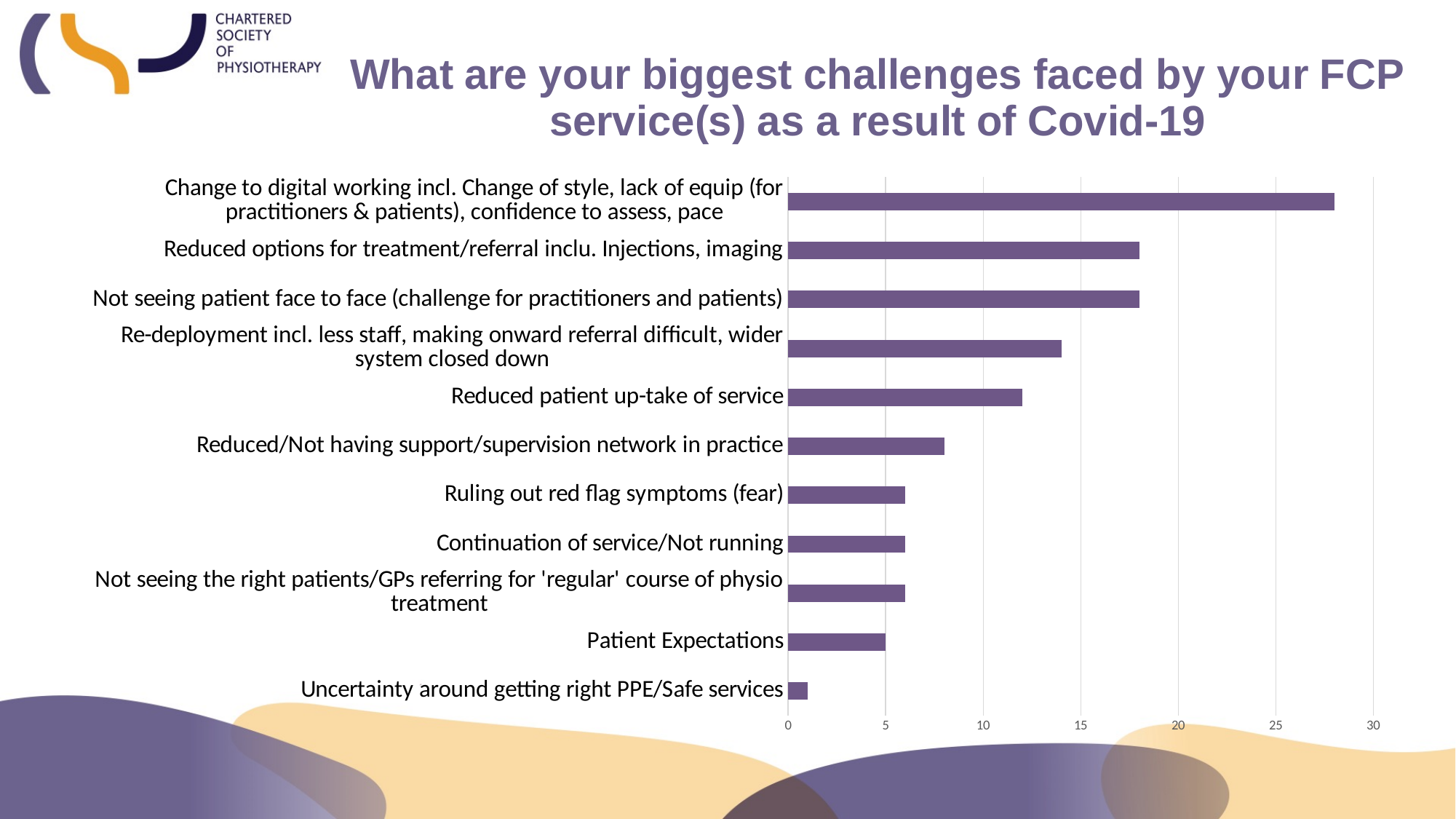
Is the value for 'Re-deployment incl. less staff, making onward referral difficult, wider system closed down' greater or less than 15? less Which has the larger value: 'Re-deployment incl. less staff, making onward referral difficult, wider system closed down' or 'Patient Expectations'? Re-deployment incl. less staff, making onward referral difficult, wider system closed down Is the value for 'Uncertainty around getting right PPE/Safe services' greater or less than 5? less What kind of chart is shown on the slide? bar chart Is the value for 'Change to digital working' greater or less than 25? greater Which has the larger value: 'Reduced patient up-take of service' or 'Reduced/Not having support/supervision network in practice'? Reduced patient up-take of service How many challenge categories are plotted in the chart? 11 What is the title of the chart on the slide? What are your biggest challenges faced by your FCP service(s) as a result of Covid-19 Which challenge has the lowest value in the chart? Uncertainty around getting right PPE/Safe services Which challenge has the highest value in the chart? Change to digital working incl. Change of style, lack of equip (for practitioners & patients), confidence to assess, pace